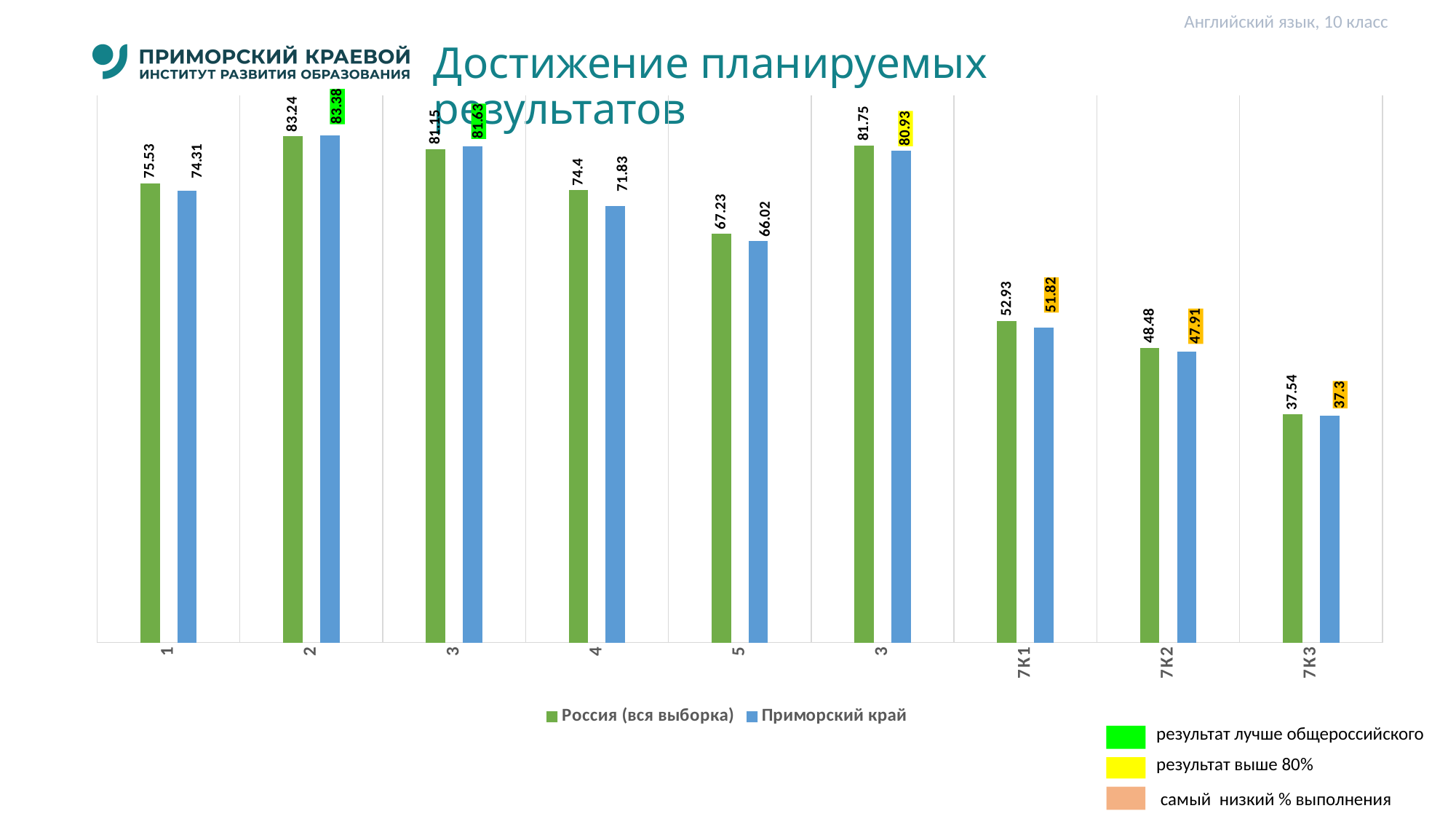
What is the value for Приморский край in category 2? 83.38 Which category has the highest value for Приморский край? 2 Do the values for Приморский край rise or fall from category 7К1 to 7К3? fall How many series does the chart legend list? 2 What is the value for Приморский край in category 7К1? 51.82 What is the value for Россия (вся выборка) in category 5? 67.23 What are the two series named in the chart legend? Россия (вся выборка) and Приморский край Which category has the lowest value for Россия (вся выборка)? 7К3 What is the difference between the Россия (вся выборка) and Приморский край values in category 4? 2.57 What kind of chart is shown on the slide? bar chart In category 7К2, which is larger: the value for Россия (вся выборка) or for Приморский край? Россия (вся выборка) How many categories are shown along the x axis of the chart? 9